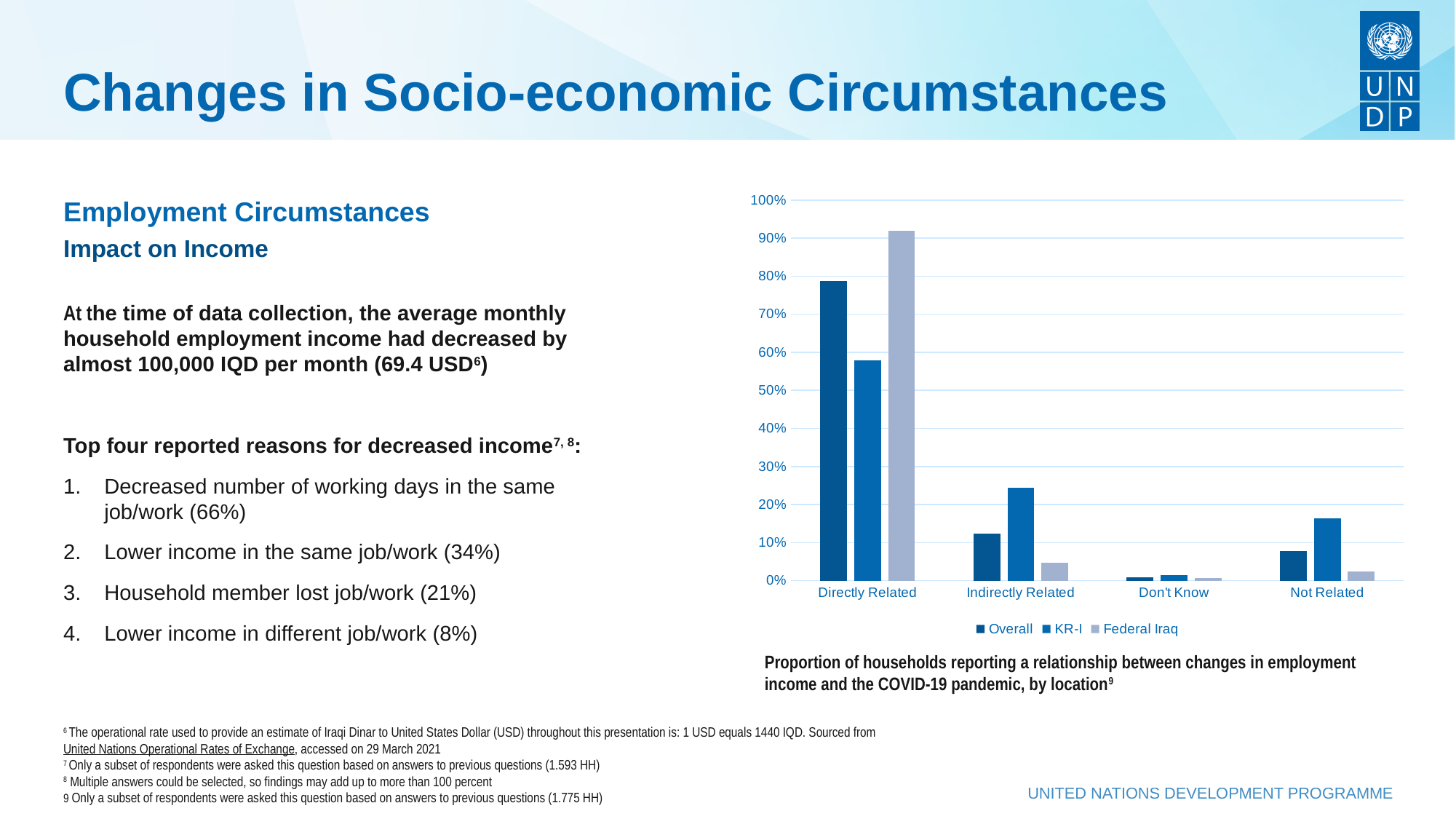
Which series has the lowest value in the Directly Related category? KR-I Which series has the highest value in the Directly Related category? Federal Iraq Which category has the lowest value for the Overall series? Don't Know In the Not Related category, which is larger: the KR-I value or the Federal Iraq value? KR-I What are the three series listed in the chart legend? Overall, KR-I, Federal Iraq How many categories are shown on the x axis of the chart? 4 Which category has the highest value for the Federal Iraq series? Directly Related How many series does the chart legend list? 3 Is the value for Overall in the Directly Related category greater or less than 70%? greater Is the value for Federal Iraq in the Directly Related category greater or less than 90%? greater Is the value for KR-I in the Indirectly Related category greater or less than 20%? greater What kind of chart is shown on the slide? bar chart